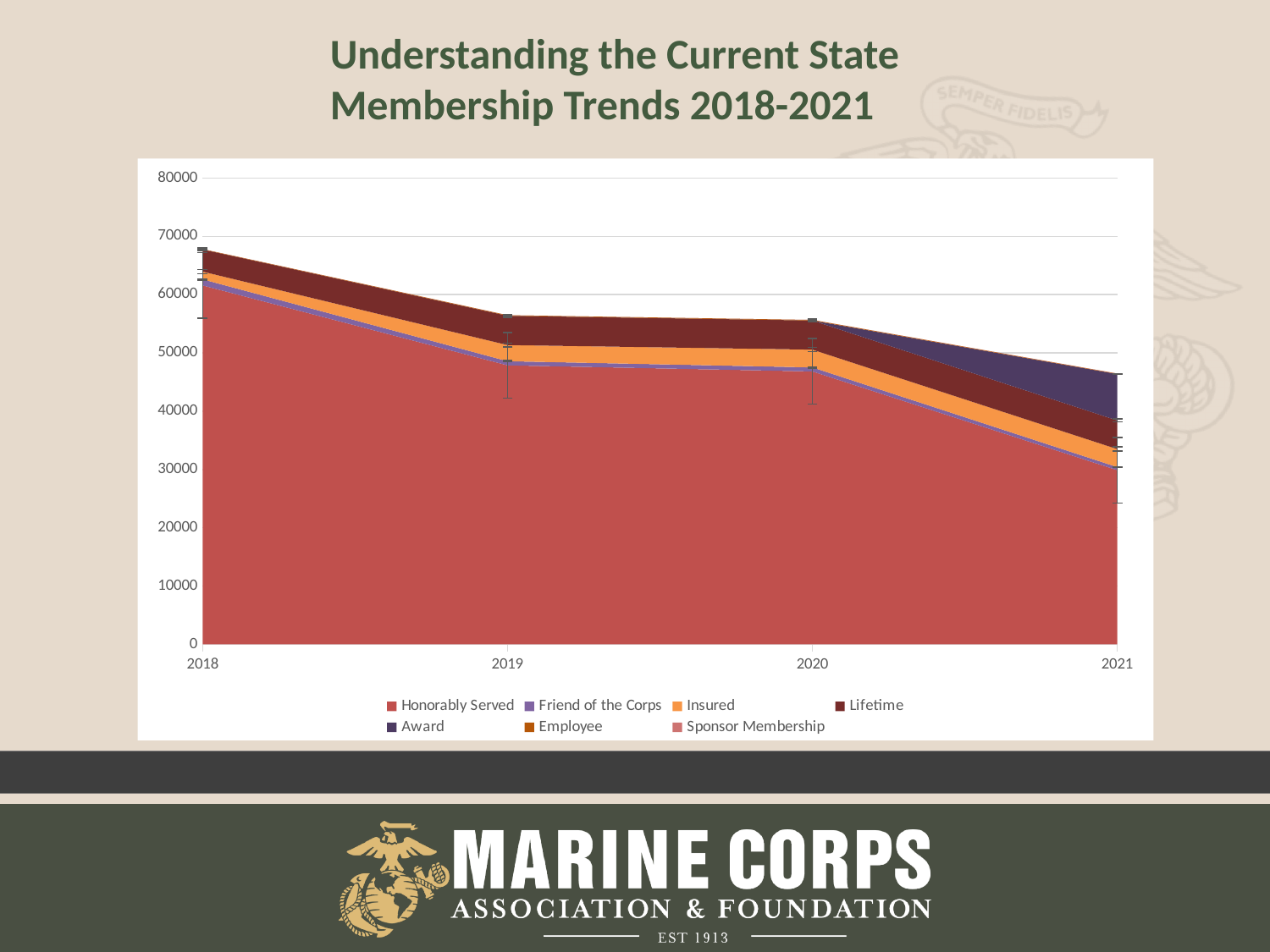
What is the title of the slide containing the chart? Understanding the Current State Membership Trends 2018-2021 How many years are plotted along the x axis? 4 Is the total stacked value for 2018 greater or less than 60000? greater Is the value for Honorably Served in 2019 greater or less than 50000? less Which year has the lowest total membership? 2021 How many series does the legend list? 7 Is the total stacked value for 2021 greater or less than 50000? less Does the total membership rise or fall from 2018 to 2021? Fall Which series makes up the largest part of the stacked area? Honorably Served Which year has the highest total membership? 2018 What kind of chart is shown on the slide? Stacked area chart